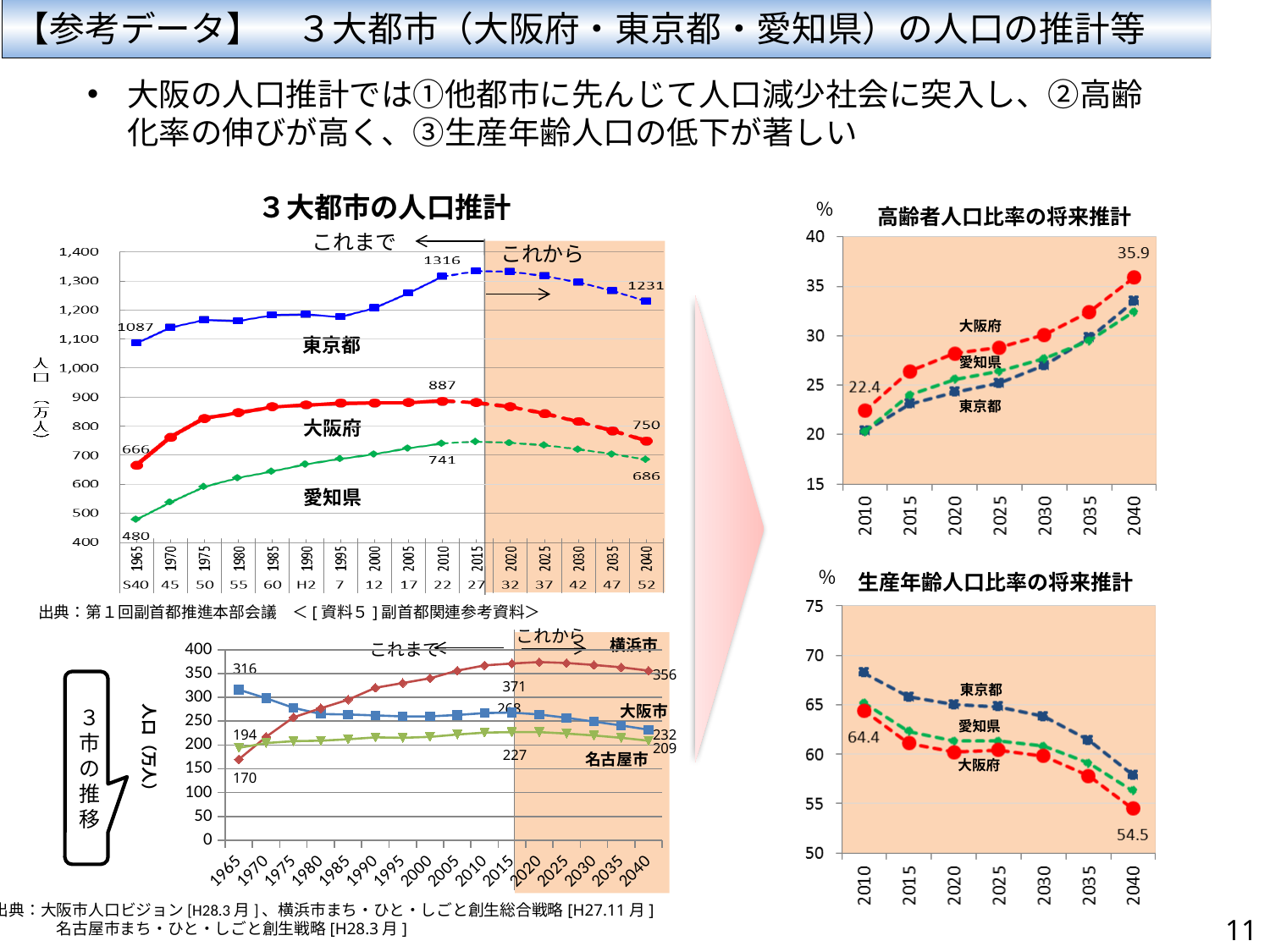
In the chart titled ３大都市の人口推計, what is the labelled value for 大阪府 in 2040? 750 In the chart titled ３大都市の人口推計, which prefecture has the highest population line? 東京都 In the chart titled ３大都市の人口推計, what is the labelled value for 東京都 in 2010? 1316 In the chart titled 生産年齢人口比率の将来推計, what is the labelled value for 大阪府 in 2010? 64.4 In the chart titled ３大都市の人口推計, what is the difference between the 東京都 values labelled 1316 and 1087? 229 What kind of chart is the one titled ３大都市の人口推計? line chart In the chart titled 生産年齢人口比率の将来推計, is the value for 東京都 in 2040 greater or less than 55? greater In the chart titled 高齢者人口比率の将来推計, what is the difference between the 大阪府 values labelled for 2040 and 2010? 13.5 In the chart titled 生産年齢人口比率の将来推計, do the values rise or fall from 2010 to 2040? fall In the bottom-left chart of the three cities (３市の推移), which is larger in 2040, 横浜市 or 大阪市? 横浜市 In the bottom-left chart of the three cities (３市の推移), what is the labelled value for 横浜市 in 2040? 356 In the chart titled 高齢者人口比率の将来推計, what is the labelled value for 大阪府 in 2040? 35.9